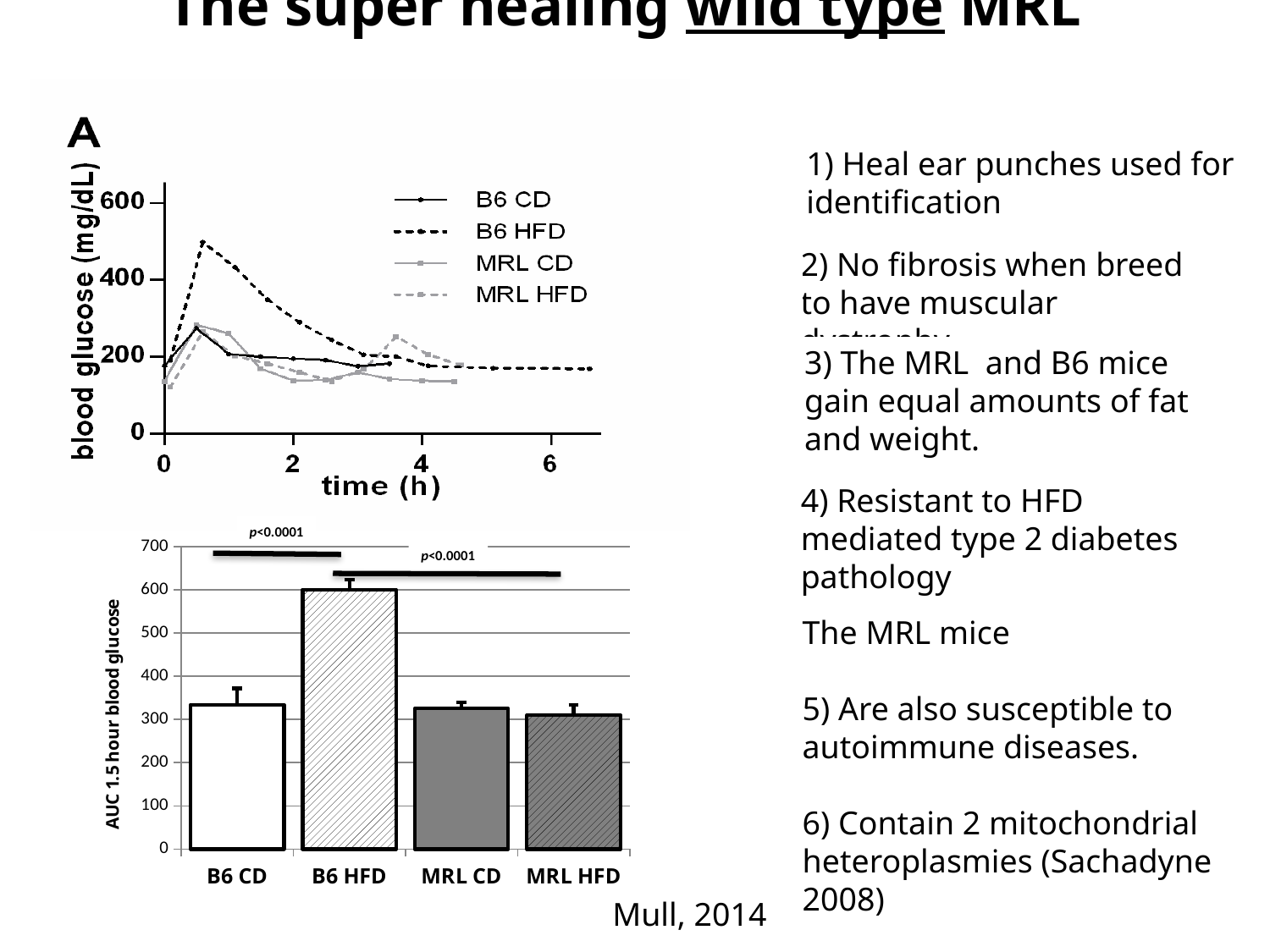
In the bottom bar chart, which group has the highest AUC 1.5 hour blood glucose? B6 HFD How many groups are shown on the x axis of the bottom bar chart? 4 In the bottom bar chart, is the value for B6 HFD greater or less than 500? greater In the bottom bar chart, which is larger, the value for B6 HFD or the value for MRL CD? B6 HFD In the top line chart, which series reaches the highest peak blood glucose? B6 HFD What is the x axis label of the top line chart? time (h) What kind of chart is the top chart (panel A, blood glucose vs time)? line chart What kind of chart is the bottom chart (AUC 1.5 hour blood glucose)? bar chart In the bottom bar chart, is the value for MRL HFD greater or less than 400? less In the top line chart, is the peak value of the B6 HFD series greater or less than 400? greater How many series does the legend of the top line chart list? 4